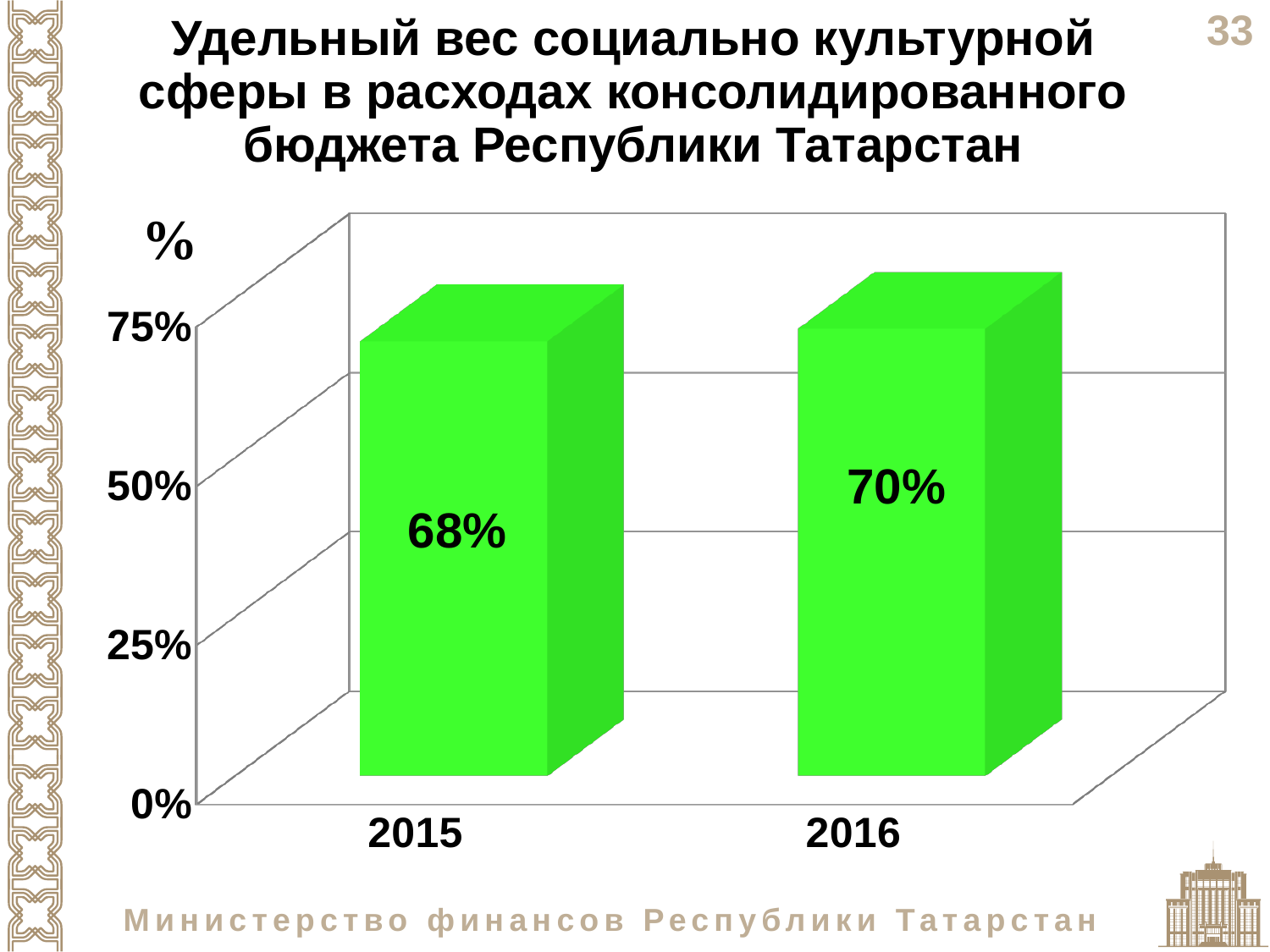
Which is larger, the value for 2015 or the value for 2016? 2016 What is the value for 2015? 68% How many years are shown on the chart? 2 Do the values rise or fall from 2015 to 2016? rise Is the value for 2015 greater or less than 50%? greater What is the difference between the values for 2016 and 2015? 2% What colour are the bars on the chart? green What is the value for 2016? 70% Which year has the highest value? 2016 What kind of chart is shown on the slide? bar chart Which year has the lowest value? 2015 Is the value for 2016 greater or less than 75%? less